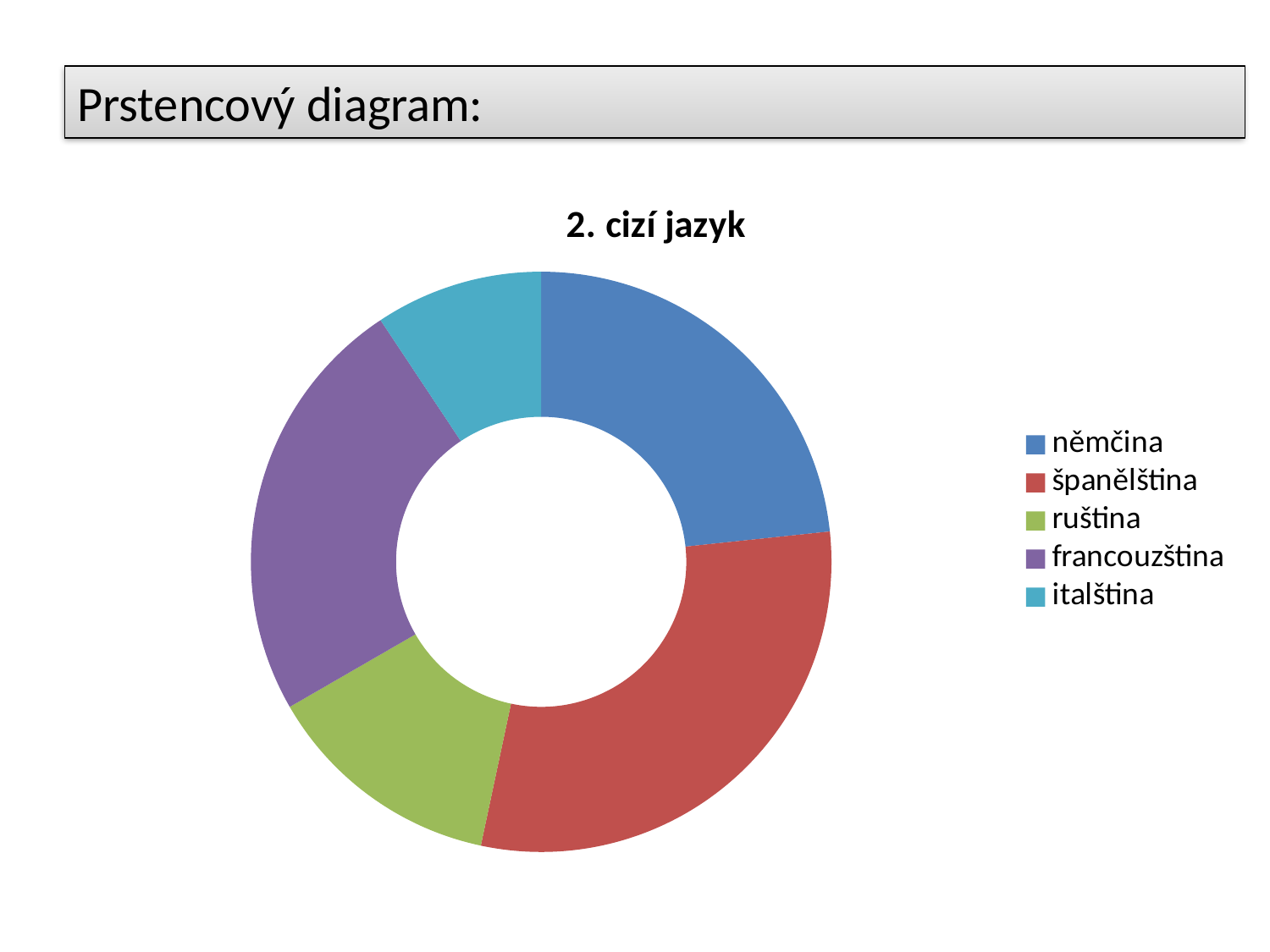
Which has the larger share, němčina or ruština? němčina How many entries does the legend list? 5 Which category has the smallest share of the doughnut? italština Which has the larger share, ruština or italština? ruština How many categories does the chart show? 5 Which category has the largest share of the doughnut? španělština What kind of chart is shown on the slide? doughnut chart Which has the larger share, francouzština or ruština? francouzština What is the title of the chart? 2. cizí jazyk Which category is shown in red? španělština